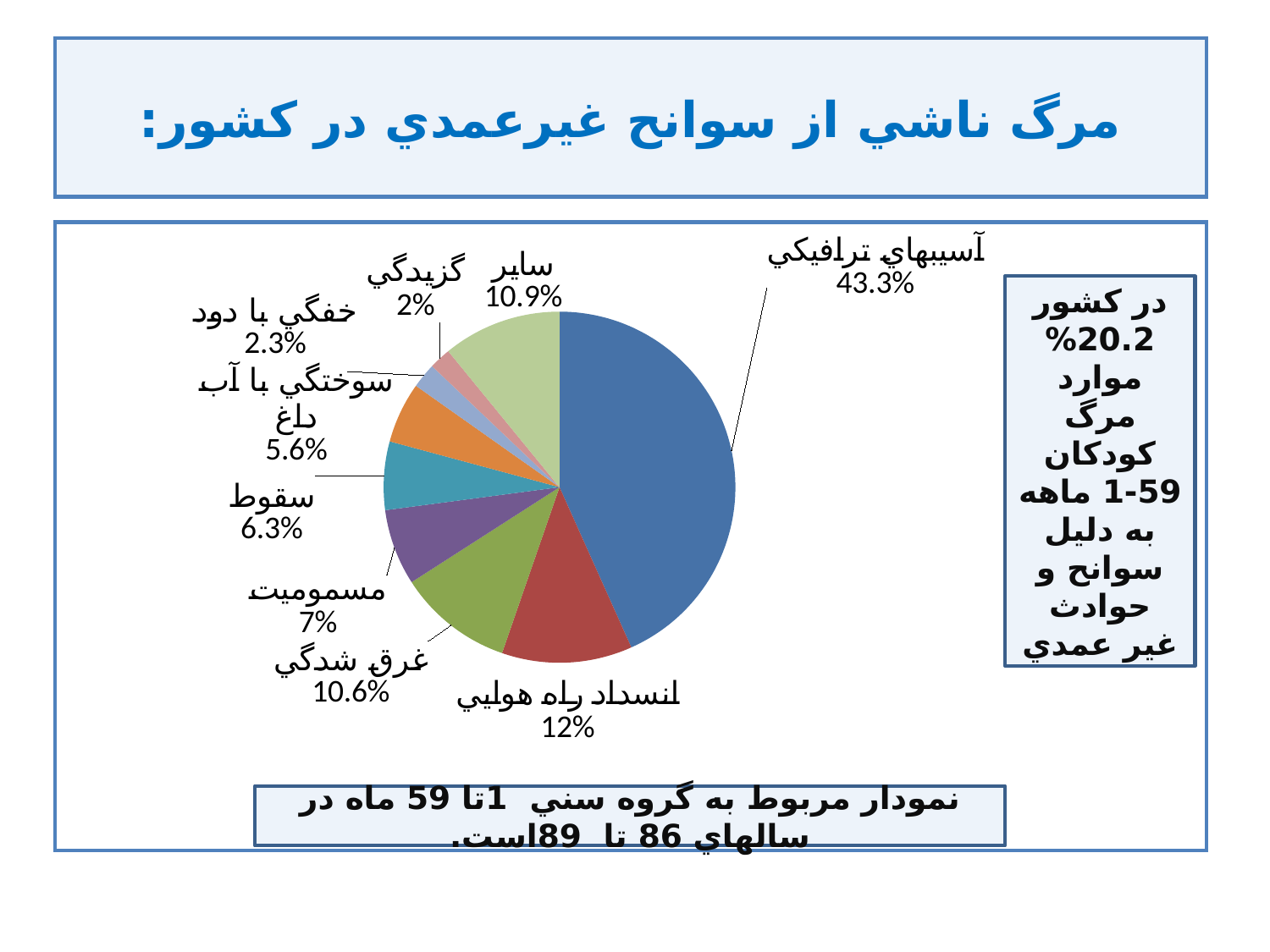
What kind of chart is shown on the slide? pie chart What is the combined percentage of غرق شدگي (drowning) and مسموميت (poisoning)? 17.6% What percentage is shown for غرق شدگي (drowning)? 10.6% What share of the pie is labelled آسيبهاي ترافيكي (traffic injuries)? 43.3% What is the difference in percentage points between مسموميت (poisoning) and سقوط (falls)? 0.7 Which category has the smallest share of the pie? گزيدگي How many slices does the pie chart have? 9 Which category has the largest share of the pie? آسيبهاي ترافيكي What percentage is shown for the ساير (other) slice? 10.9% What percentage is shown for انسداد راه هوايي (airway obstruction)? 12% What percentage is shown for سقوط (falls)? 6.3% Which is larger, the share for سوختگي با آب داغ (scalding) or the share for خفگي با دود (smoke suffocation)? سوختگي با آب داغ